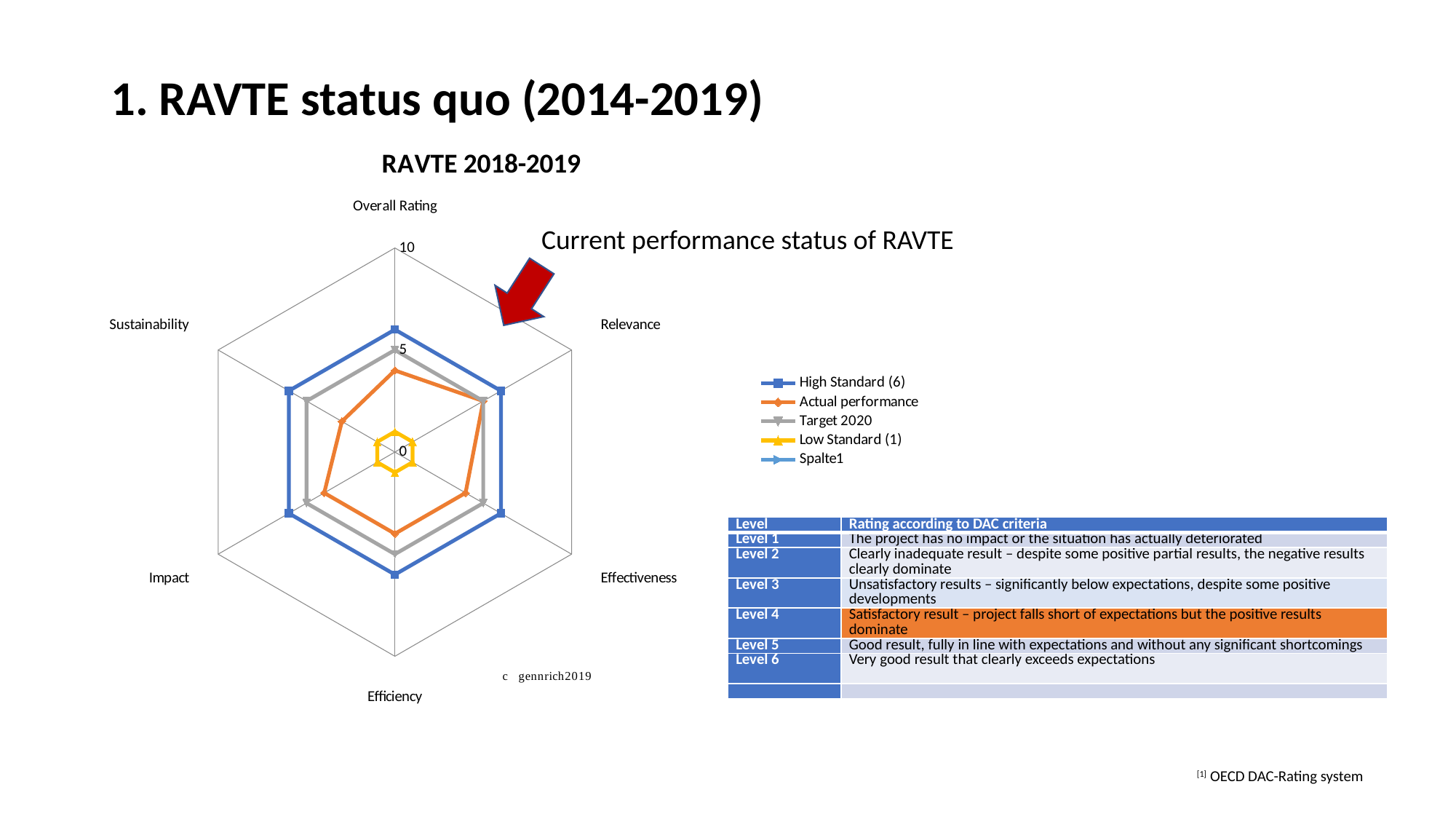
Is the High Standard (6) value for Relevance greater or less than 5? greater Is the Low Standard (1) value for Efficiency greater or less than 5? less On which axis does the Actual performance series reach its lowest value? Sustainability What kind of chart is shown on the slide? radar chart How many categories (axes) does the radar chart have? 6 How many series does the chart legend list? 5 Is the Actual performance value for Overall Rating greater or less than 5? less For Overall Rating, which is larger: High Standard (6) or Actual performance? High Standard (6) Which series is drawn in orange? Actual performance What is the title of the chart? RAVTE 2018-2019 On which axis does the Actual performance series reach its highest value? Relevance